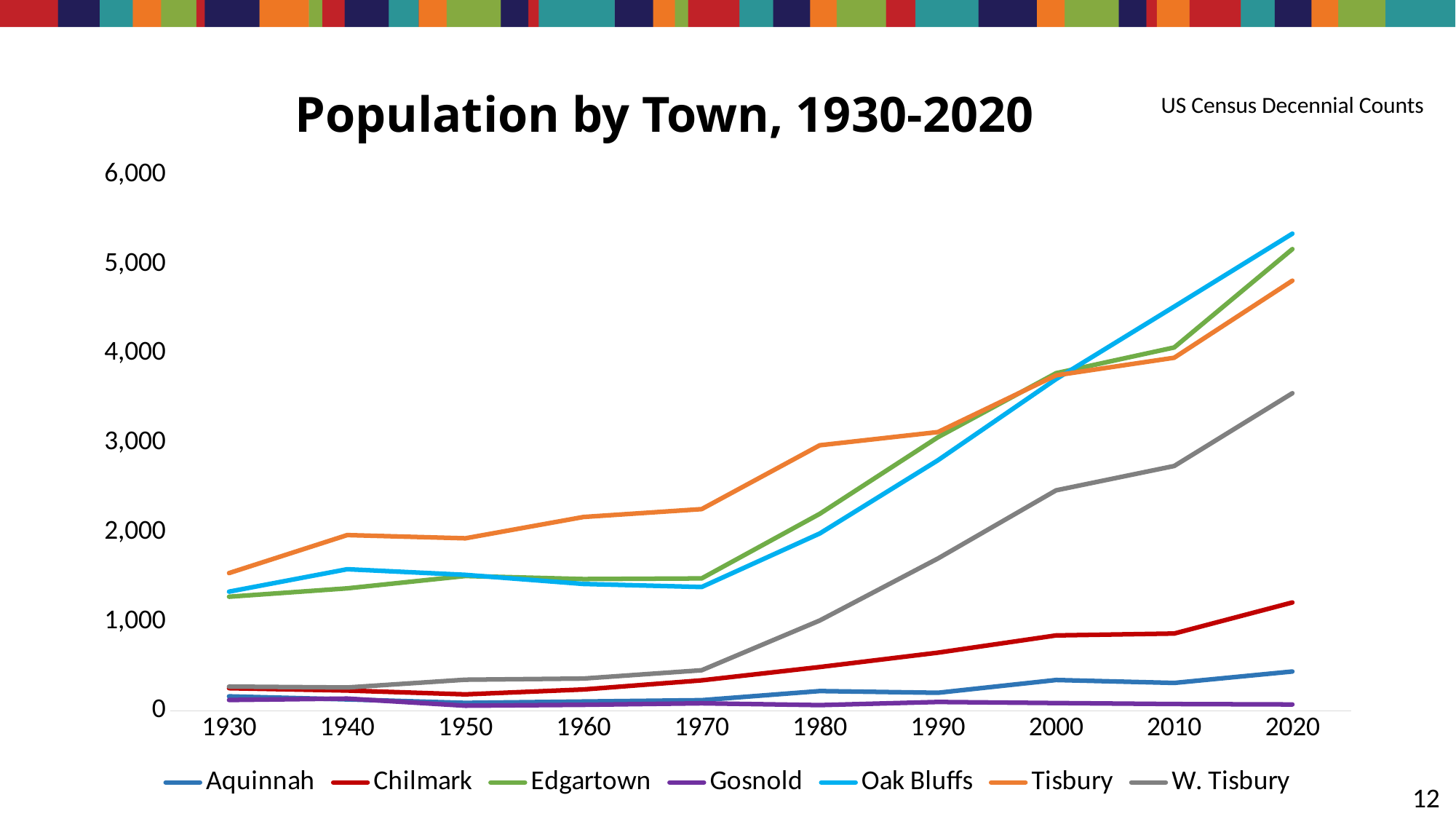
Which town had the highest population in 1980? Tisbury How many towns (series) does the legend list? 7 In 1980, which town had the larger population, Tisbury or Edgartown? Tisbury How many census years are plotted along the x axis? 10 In 2020, which town had the larger population, W. Tisbury or Chilmark? W. Tisbury Which town had the lowest population in 2020? Gosnold What is the title of the chart? Population by Town, 1930-2020 Does the population of W. Tisbury rise or fall from 1970 to 2020? Rises Is the population of W. Tisbury in 2000 greater or less than 2,000? greater What kind of chart is shown on the slide? Line chart Is the population of Edgartown in 1930 greater or less than 2,000? less Is the population of Oak Bluffs in 2020 greater or less than 5,000? greater